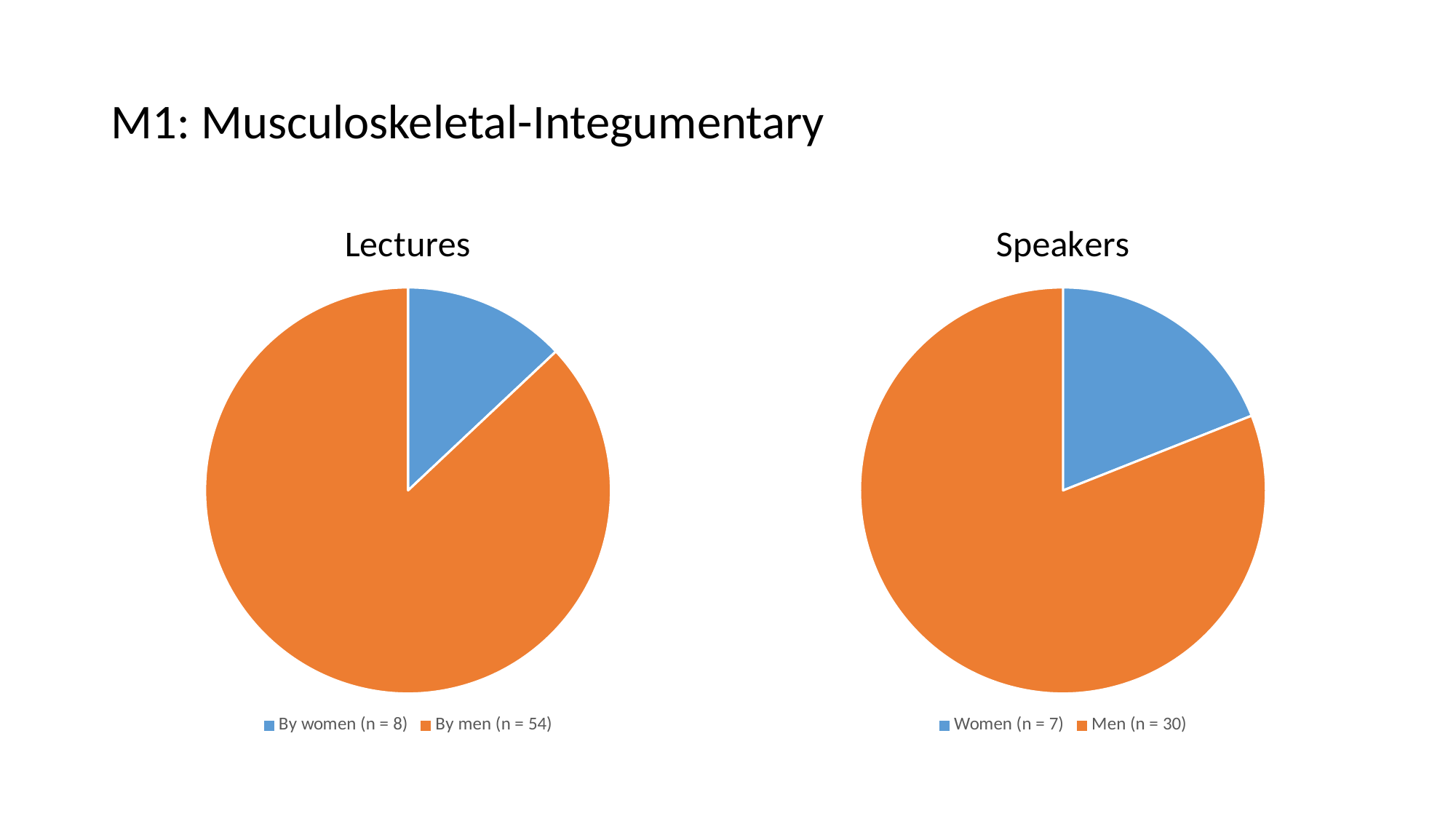
In the Speakers chart, how many speakers were women? 7 What type of chart is the Speakers chart? Pie chart In the Lectures chart, how many lectures were given by women? 8 In the Lectures chart, what is the difference between the number of lectures by men and by women? 46 In the Speakers chart, which category has the smaller slice? Women (n = 7) In the Speakers chart, what is the total number of speakers across both slices? 37 In the Lectures chart, how many lectures were given by men? 54 What colour is the slice for women in the Speakers chart? Blue How many slices does the Lectures pie chart have? 2 In the Speakers chart, what is the difference between the number of men and women speakers? 23 In the Speakers chart, how many speakers were men? 30 In the Lectures chart, which category has the larger slice? By men (n = 54)